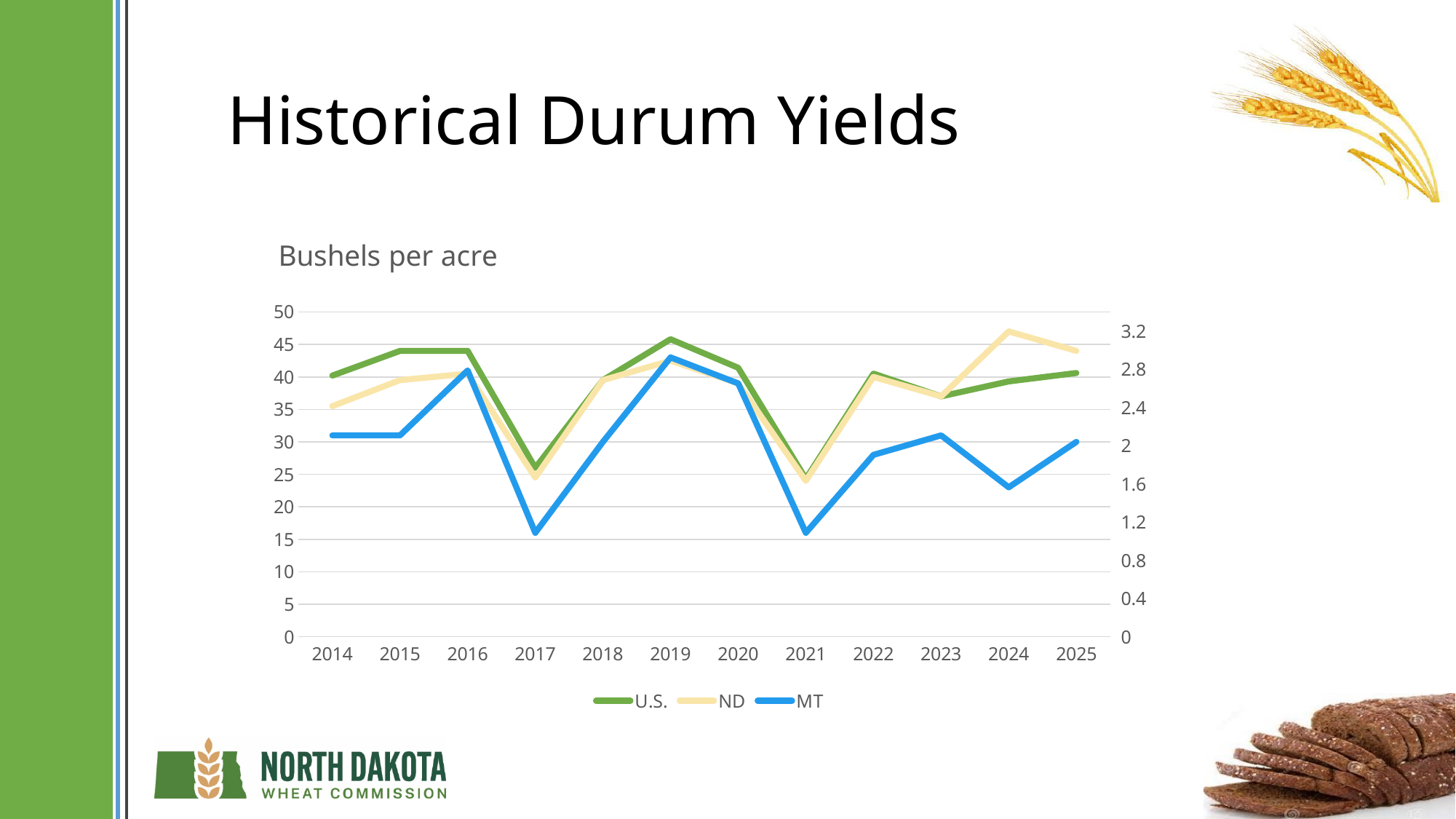
How many years are plotted along the x axis? 12 Is the value for ND in 2024 greater or less than 45? greater In 2017, which series has the larger value, U.S. or MT? U.S. Is the value for MT in 2017 greater or less than 20? less In 2024, which series has the larger value, ND or MT? ND In which year does the ND series reach its highest value? 2024 Is the value for MT in 2024 greater or less than 25? less What is the title of the chart on the slide? Bushels per acre Does the MT series rise or fall from 2014 to 2016? Rise How many series does the legend list? 3 In which year does the MT series reach its highest value? 2019 What kind of chart is shown on the slide? Line chart